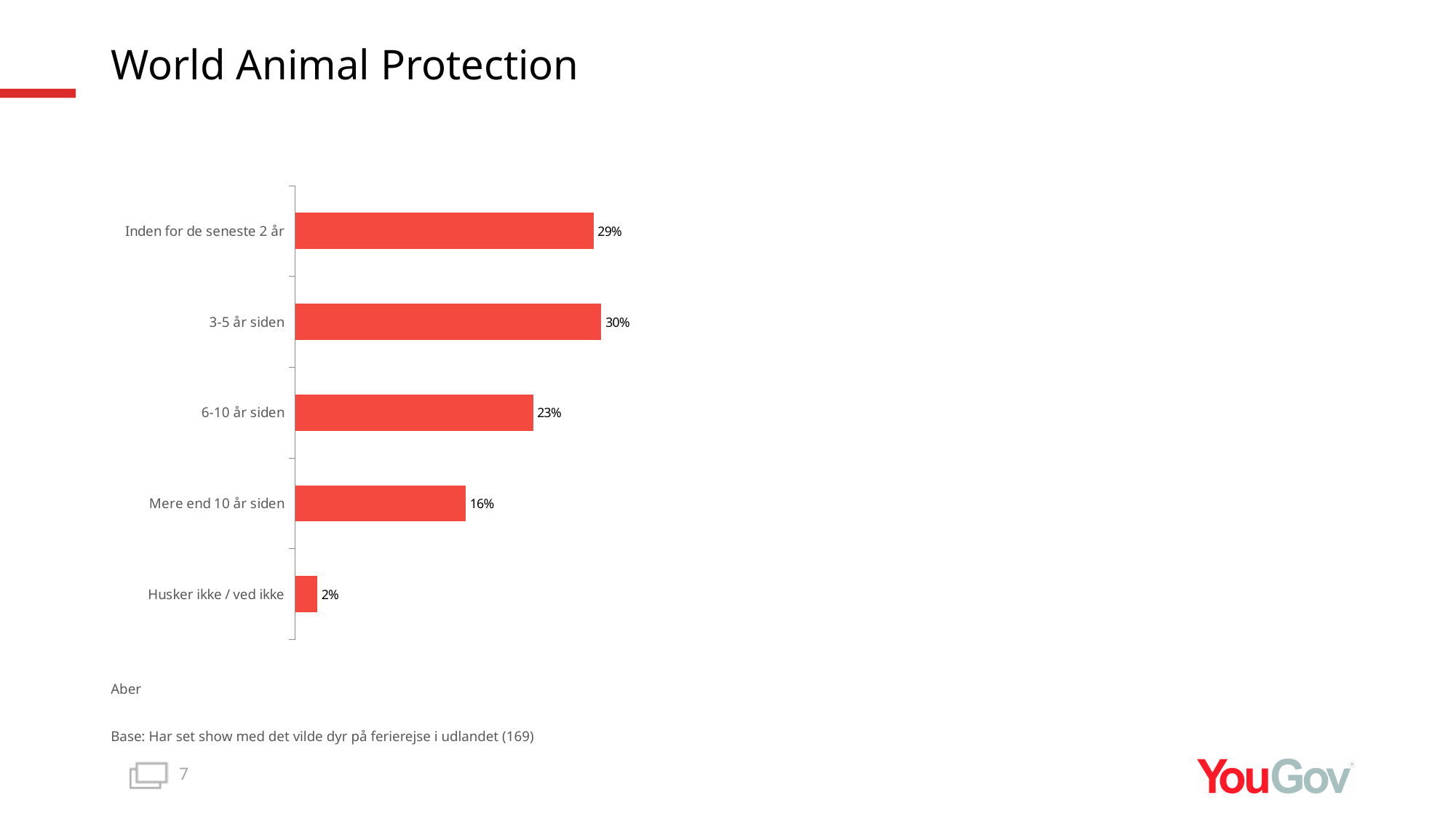
What is the base size stated below the chart? 169 What type of chart is shown on the slide? Bar chart How many categories are shown in the chart? 5 Which is larger: the value for "Inden for de seneste 2 år" or the value for "6-10 år siden"? Inden for de seneste 2 år What is the value for "3-5 år siden"? 30% Which category has the lowest value? Husker ikke / ved ikke What is the value for "Mere end 10 år siden"? 16% What is the difference between the values for "6-10 år siden" and "Mere end 10 år siden"? 7% What percentage is shown for "Inden for de seneste 2 år"? 29% What percentage is shown for "6-10 år siden"? 23% Which category has the highest value? 3-5 år siden What percentage is shown for "Husker ikke / ved ikke"? 2%